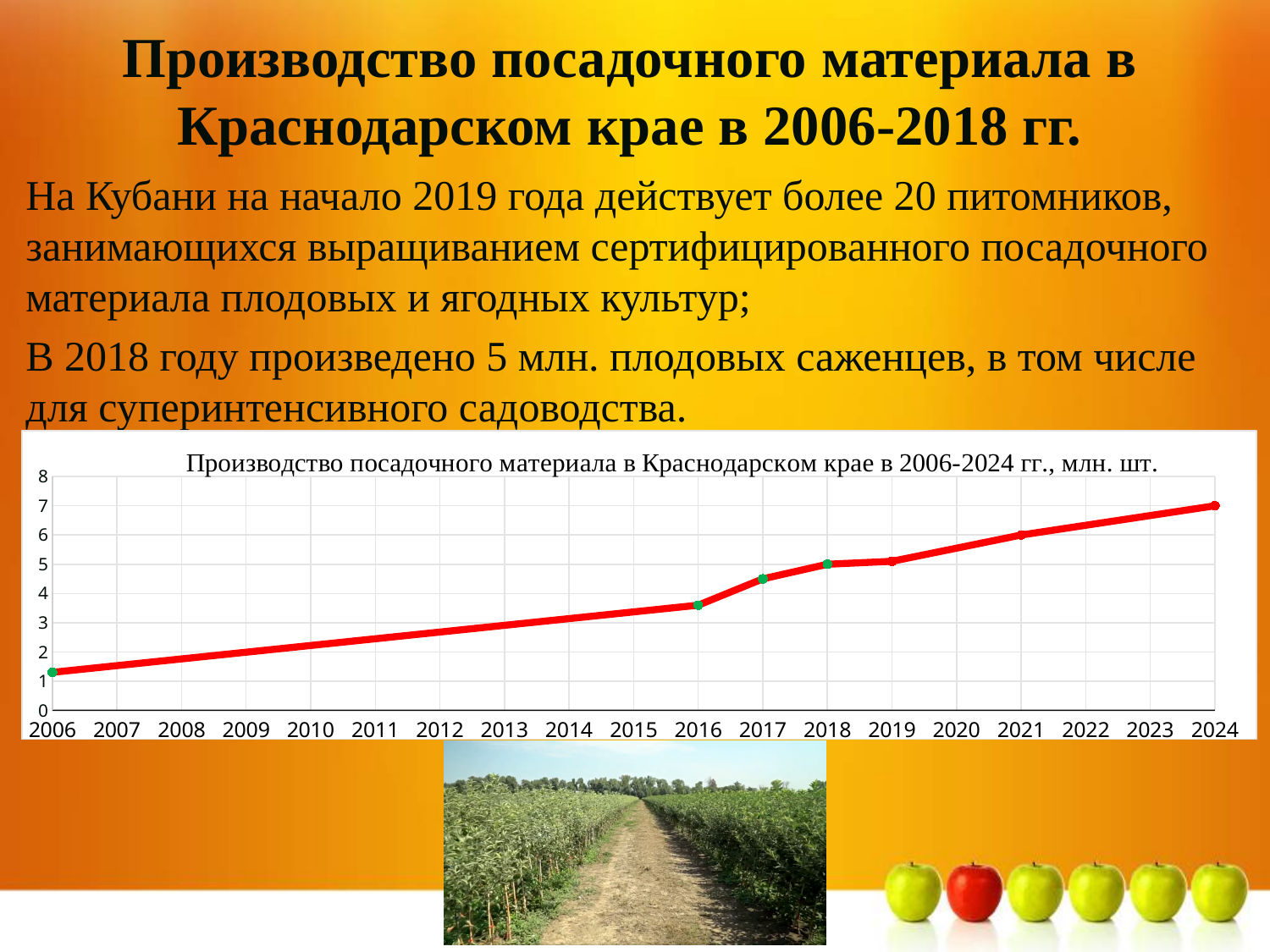
How many years are plotted along the x axis of the chart? 19 Do the values in the chart rise or fall from 2006 to 2024? rise Which year has the larger value, 2010 or 2020? 2020 What is the value for 2018 in the chart, in млн. шт.? 5 What type of chart is shown on the slide? line chart Is the value for 2016 greater or less than 4? less Which year has the lowest value in the chart? 2006 Which year has the highest value in the chart? 2024 Is the value for 2017 greater or less than 4? greater What is the title of the chart? Производство посадочного материала в Краснодарском крае в 2006-2024 гг., млн. шт. Is the value for 2023 greater or less than 6? greater